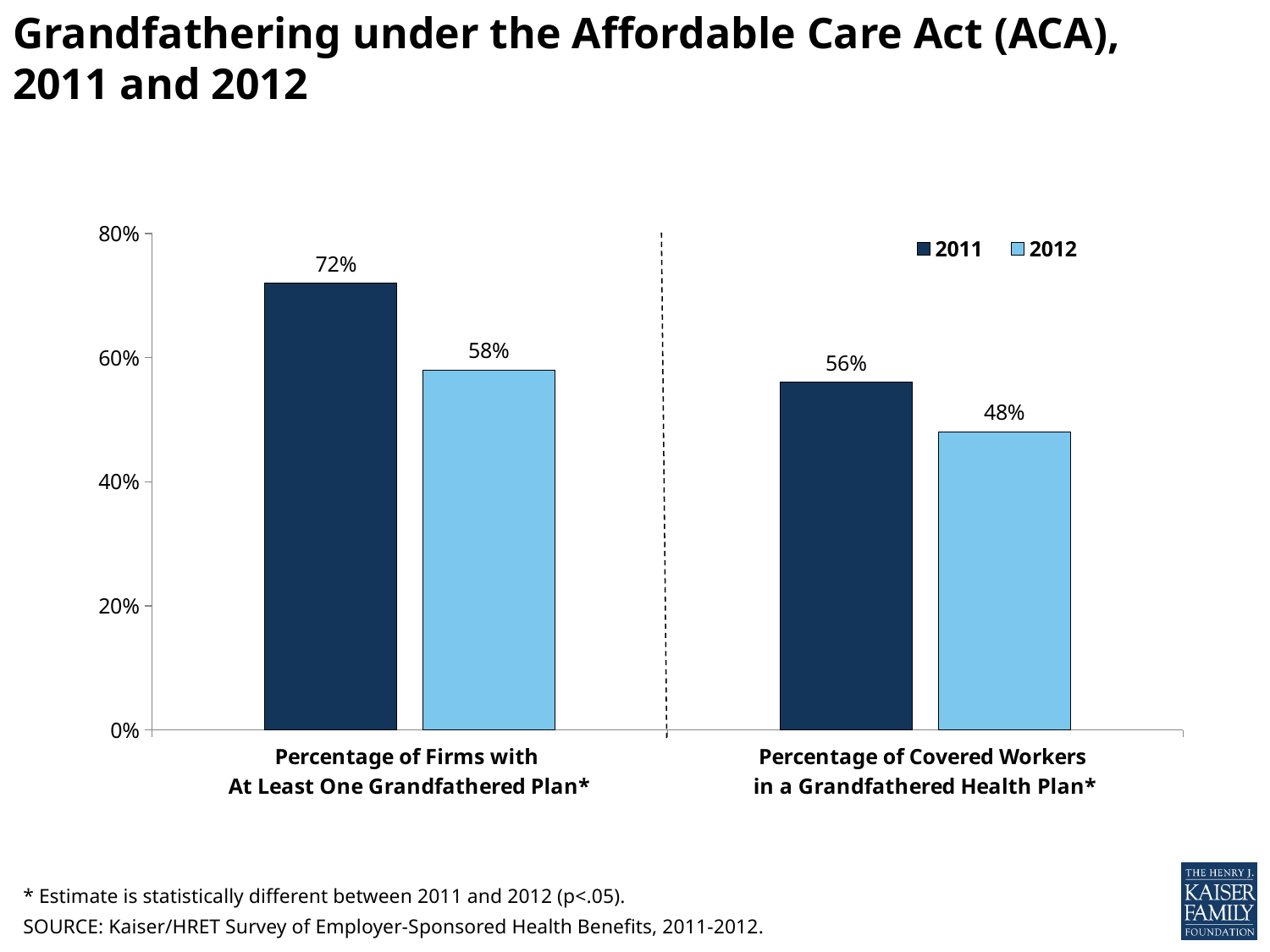
What percentage of covered workers were in a grandfathered health plan in 2012? 48% Which is larger: the 2012 percentage of firms with at least one grandfathered plan or the 2011 percentage of covered workers in a grandfathered health plan? 2012 percentage of firms with at least one grandfathered plan By how many percentage points did the percentage of firms with at least one grandfathered plan fall from 2011 to 2012? 14 What percentage of firms had at least one grandfathered plan in 2012? 58% How many series does the legend list? 2 What percentage of covered workers were in a grandfathered health plan in 2011? 56% What kind of chart is shown on the slide? Bar chart What percentage of firms had at least one grandfathered plan in 2011? 72% Which bar shows the highest value on the chart? Percentage of Firms with At Least One Grandfathered Plan, 2011 Which bar shows the lowest value on the chart? Percentage of Covered Workers in a Grandfathered Health Plan, 2012 By how many percentage points did the percentage of covered workers in a grandfathered health plan fall from 2011 to 2012? 8 Which colour represents 2012 in the chart? Light blue